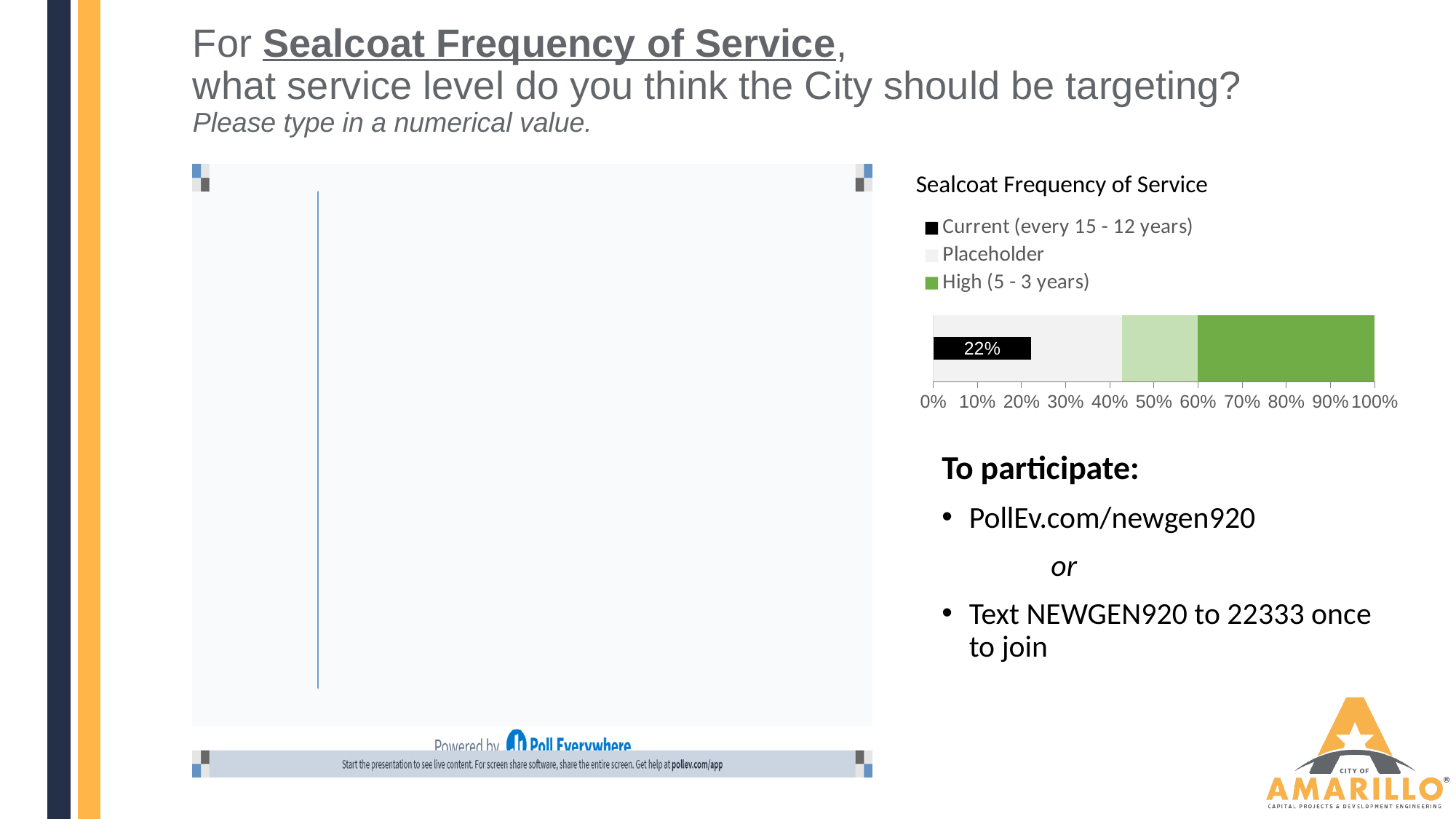
How many series does the legend of the Sealcoat Frequency of Service chart list? 3 What kind of chart is the Sealcoat Frequency of Service chart? bar chart In the Sealcoat Frequency of Service chart, is the value for Current (every 15 - 12 years) greater or less than 20%? greater What are the legend entries of the Sealcoat Frequency of Service chart? Current (every 15 - 12 years), Placeholder, High (5 - 3 years) In the Sealcoat Frequency of Service chart, is the value for Current (every 15 - 12 years) greater or less than 30%? less In the Sealcoat Frequency of Service chart, what value is shown for Current (every 15 - 12 years)? 22% What is the title of the chart on the right side of the slide? Sealcoat Frequency of Service